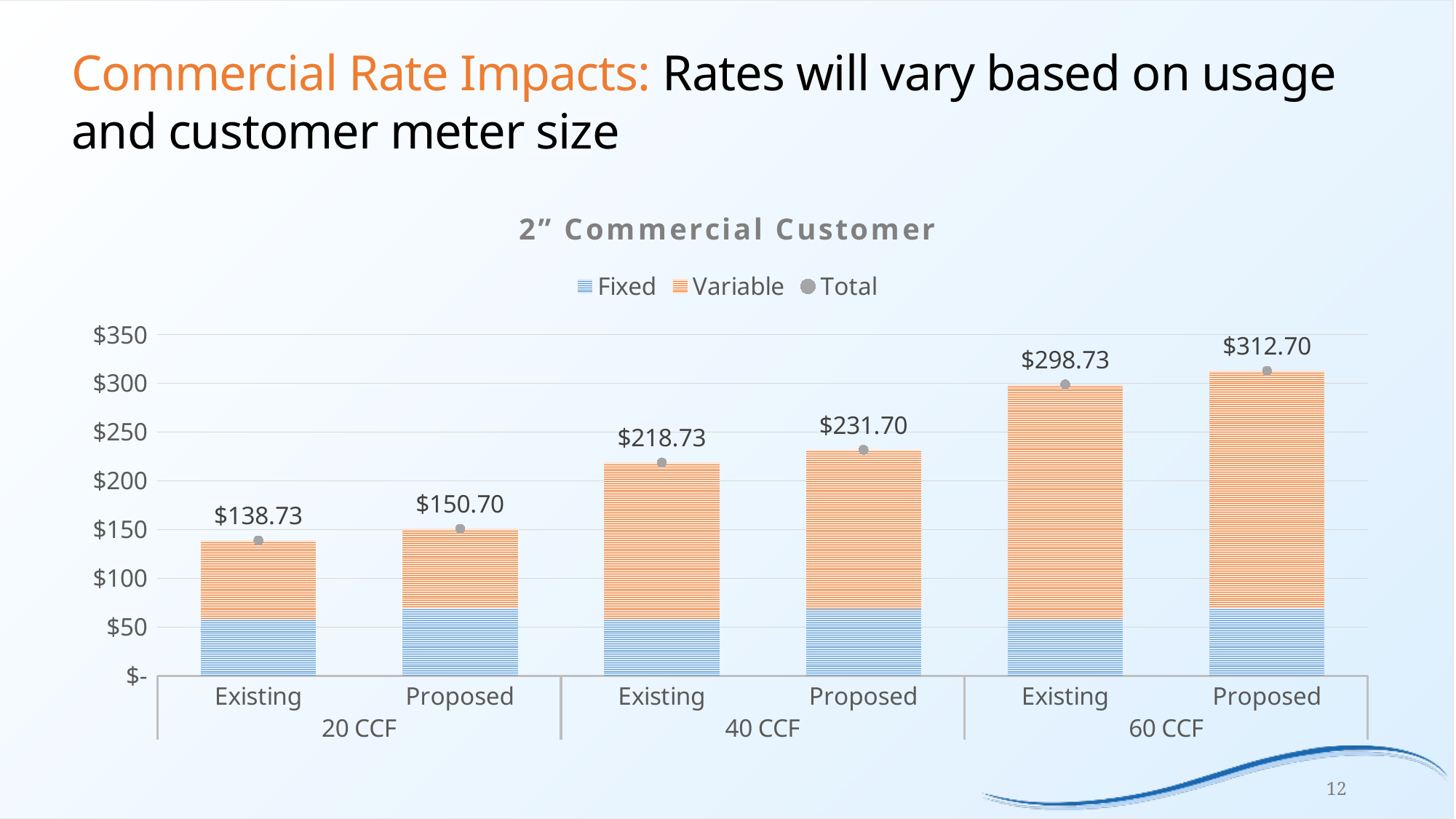
Is the Fixed portion of the Existing bar at 20 CCF greater or less than $100? less What is the Total for the Proposed rate at 60 CCF? $312.70 Which is larger, the Existing Total at 40 CCF or the Proposed Total at 20 CCF? Existing Total at 40 CCF What is the Total for the Proposed rate at 40 CCF? $231.70 How many series does the legend list? 3 What is the difference between the Existing Totals at 60 CCF and 20 CCF? $160.00 What is the difference between the Proposed and Existing Totals at 40 CCF? $12.97 How many bars are plotted in the chart? 6 Which bar has the highest Total? Proposed, 60 CCF What is the Total for the Existing rate at 20 CCF? $138.73 Which bar has the lowest Total? Existing, 20 CCF What kind of chart is shown on the slide? Stacked bar chart